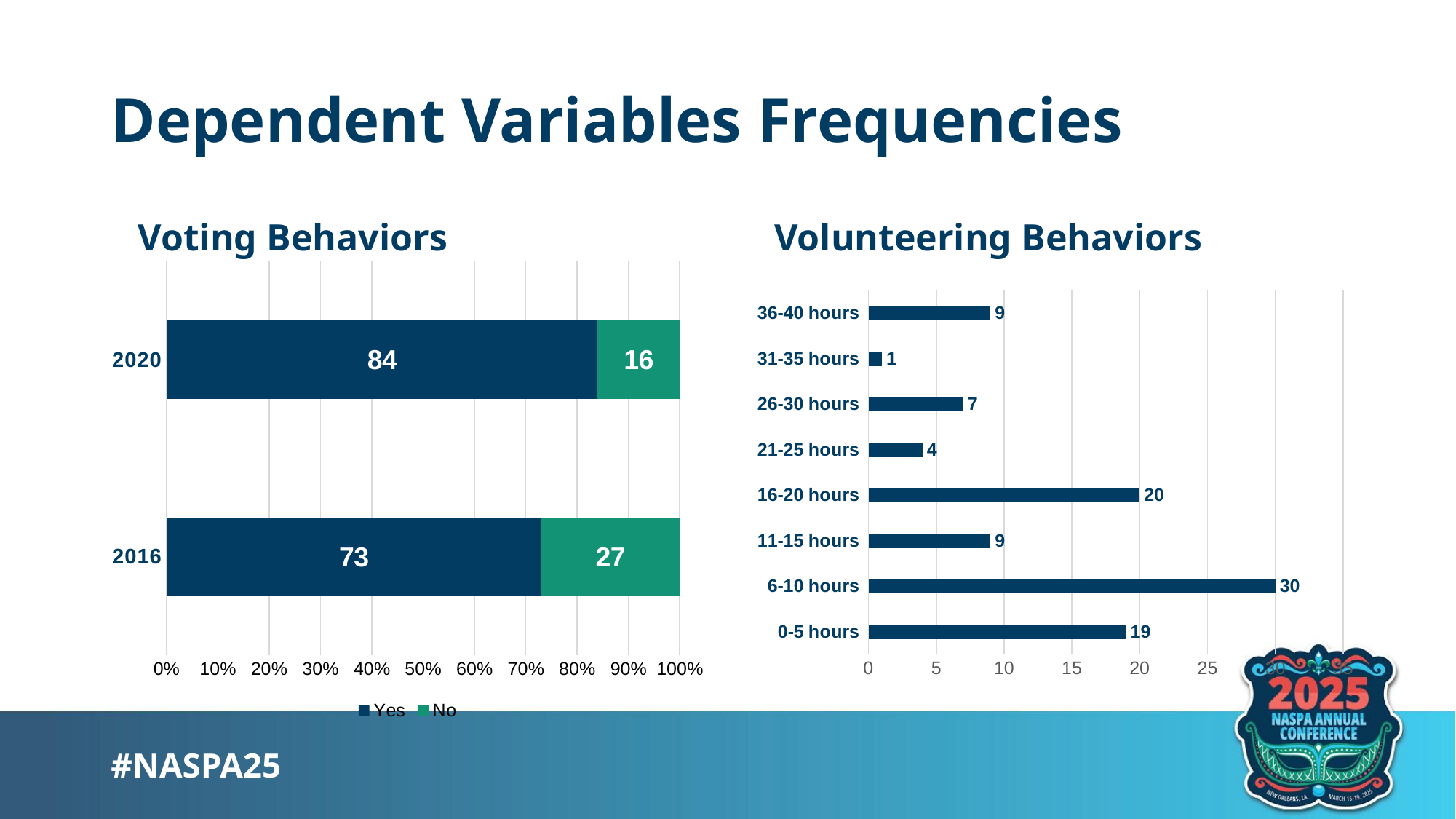
In the Volunteering Behaviors chart, what is the difference between the values for 6-10 hours and 0-5 hours? 11 What kind of chart is the Volunteering Behaviors chart? Bar chart In the Voting Behaviors chart, what is the value for No in 2016? 27 In the Volunteering Behaviors chart, what is the value for 16-20 hours? 20 In the Volunteering Behaviors chart, which category has the highest value? 6-10 hours In the Volunteering Behaviors chart, how many categories are shown? 8 In the Voting Behaviors chart, what is the difference between the Yes values for 2020 and 2016? 11 In the Volunteering Behaviors chart, which category has the lowest value? 31-35 hours In the Voting Behaviors chart, what is the total of the stacked bar for 2020? 100 In the Voting Behaviors chart, how many series does the legend list? 2 In the Voting Behaviors chart, which year has the larger No value, 2016 or 2020? 2016 In the Voting Behaviors chart, what is the value for Yes in 2020? 84